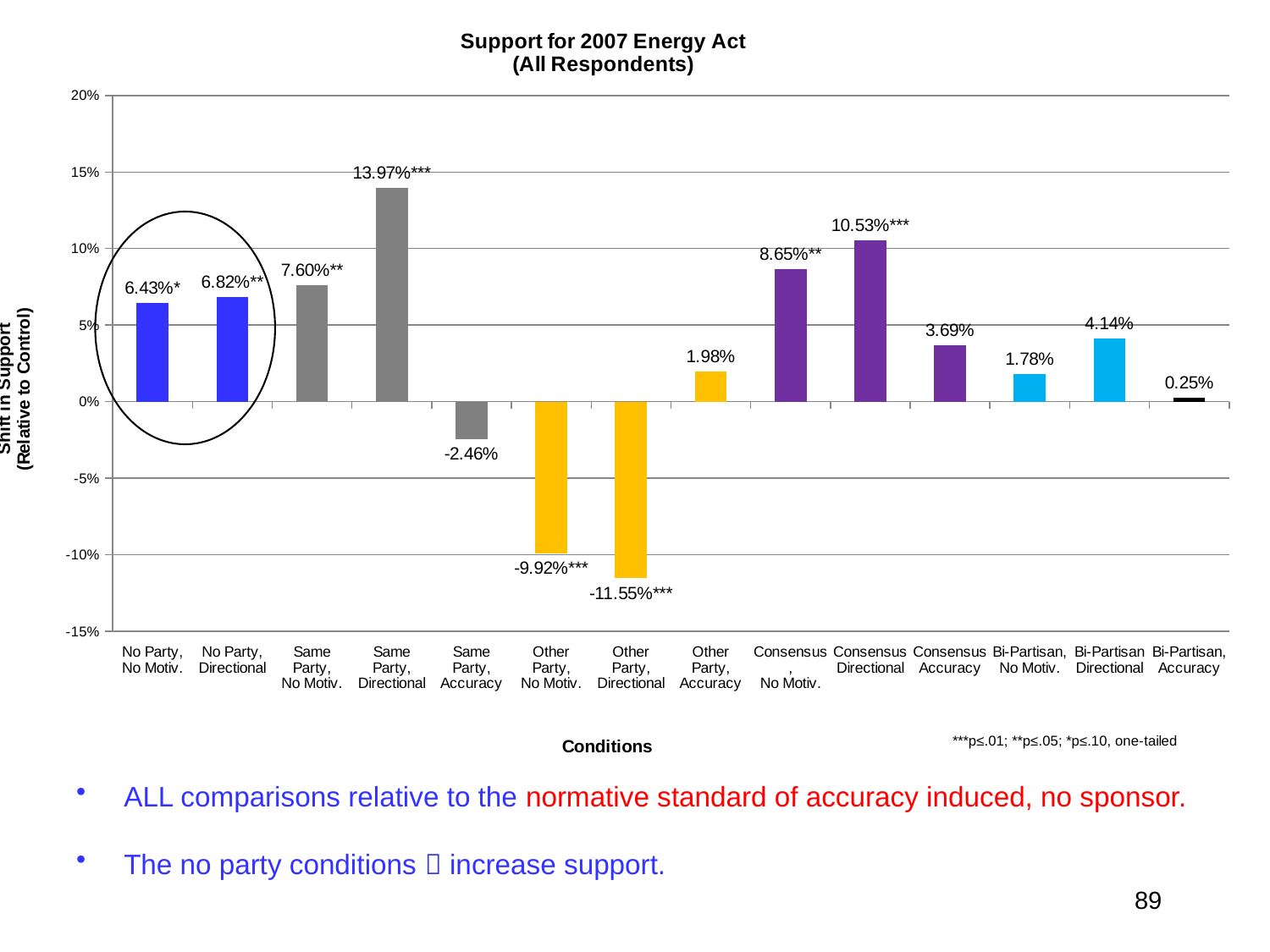
What is the value shown for the Other Party, Directional condition? -11.55%*** What is the title of the chart? Support for 2007 Energy Act (All Respondents) Which condition has the lowest shift in support? Other Party, Directional What is the value shown for the Same Party, Directional condition? 13.97%*** What is the difference between the values for Bi-Partisan, Directional and Bi-Partisan, No Motiv.? 2.36% What is the value shown for the Bi-Partisan, Accuracy condition? 0.25% How many conditions are plotted on the x axis? 14 Which condition has the highest shift in support? Same Party, Directional Which is larger, the value for Consensus, No Motiv. or the value for Same Party, No Motiv.? Consensus, No Motiv. Do the values rise or fall from Same Party, No Motiv. to Same Party, Directional? Rise What is the value shown for the Consensus, Directional condition? 10.53%*** What type of chart is shown on the slide? Bar chart